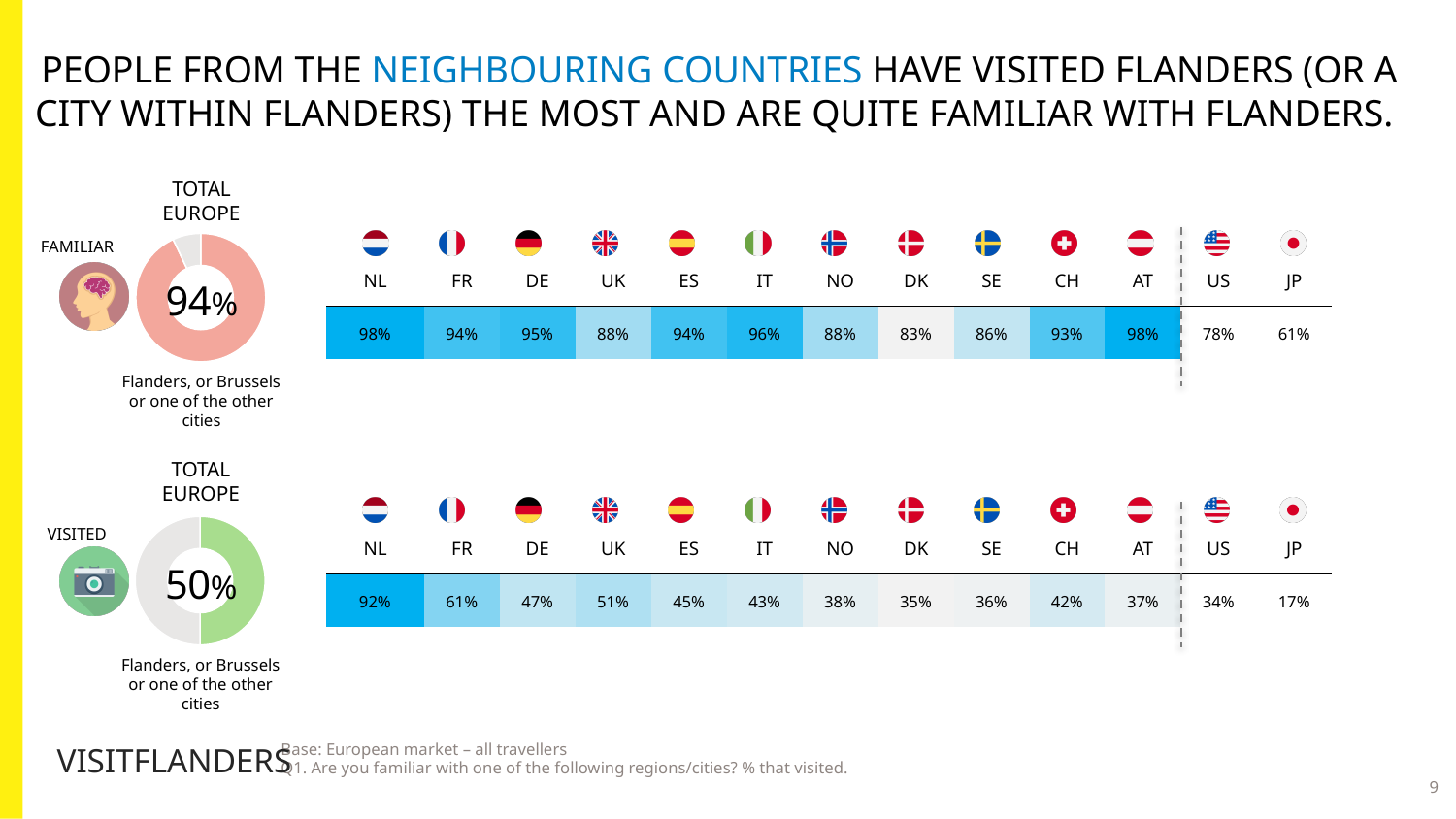
In the VISITED row by country, which country has the lowest value? JP For DK, what is the difference between the FAMILIAR value and the VISITED value? 48 percentage points In the VISITED row, what is the difference between the values for NL and FR? 31 percentage points In the FAMILIAR row by country, what is the value for NL? 98% What kind of chart is used to show the Total Europe FAMILIAR figure? Donut (pie) chart In the VISITED row by country, which country has the highest value? NL What percentage does the VISITED donut chart (Total Europe) show? 50% What percentage does the FAMILIAR donut chart (Total Europe) show? 94% How many countries are listed in the FAMILIAR row by country? 13 In the VISITED row by country, what is the value for JP? 17% In the FAMILIAR row by country, which country has the lowest value? JP In the FAMILIAR row, which is larger, the value for DE or the value for UK? DE